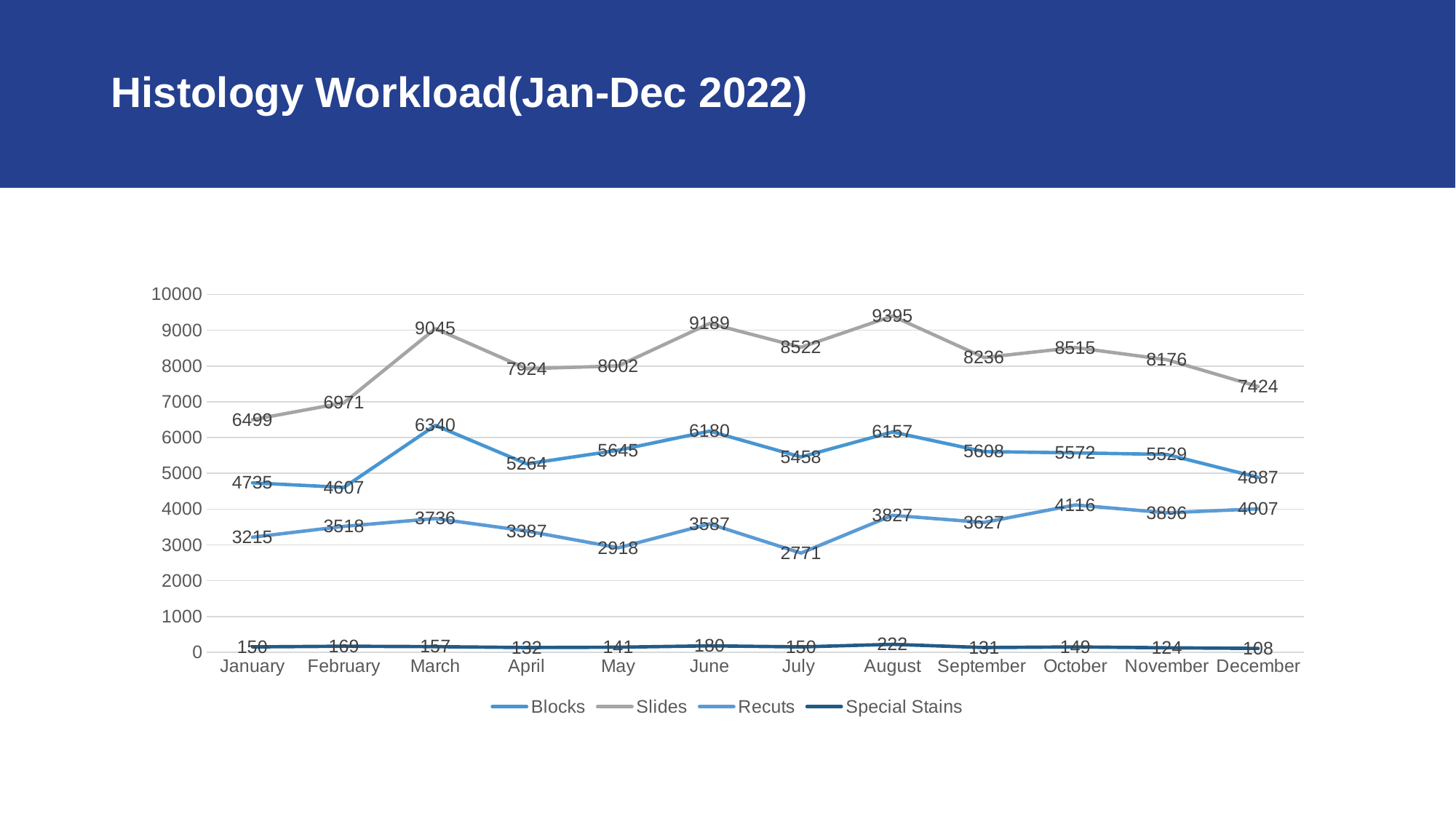
In which month is the Slides value highest? August What is the value for Blocks in March? 6340 What is the difference between the Slides values for March and December? 1621 What is the value for Special Stains in December? 108 Which is larger, the Blocks value in June or the Blocks value in August? June In which month is the Recuts value lowest? July What is the value for Slides in August? 9395 How many months are plotted on the x axis? 12 How many series does the legend list? 4 What is the title of the chart slide? Histology Workload(Jan-Dec 2022) What is the value for Recuts in July? 2771 What type of chart is shown on the slide? Line chart